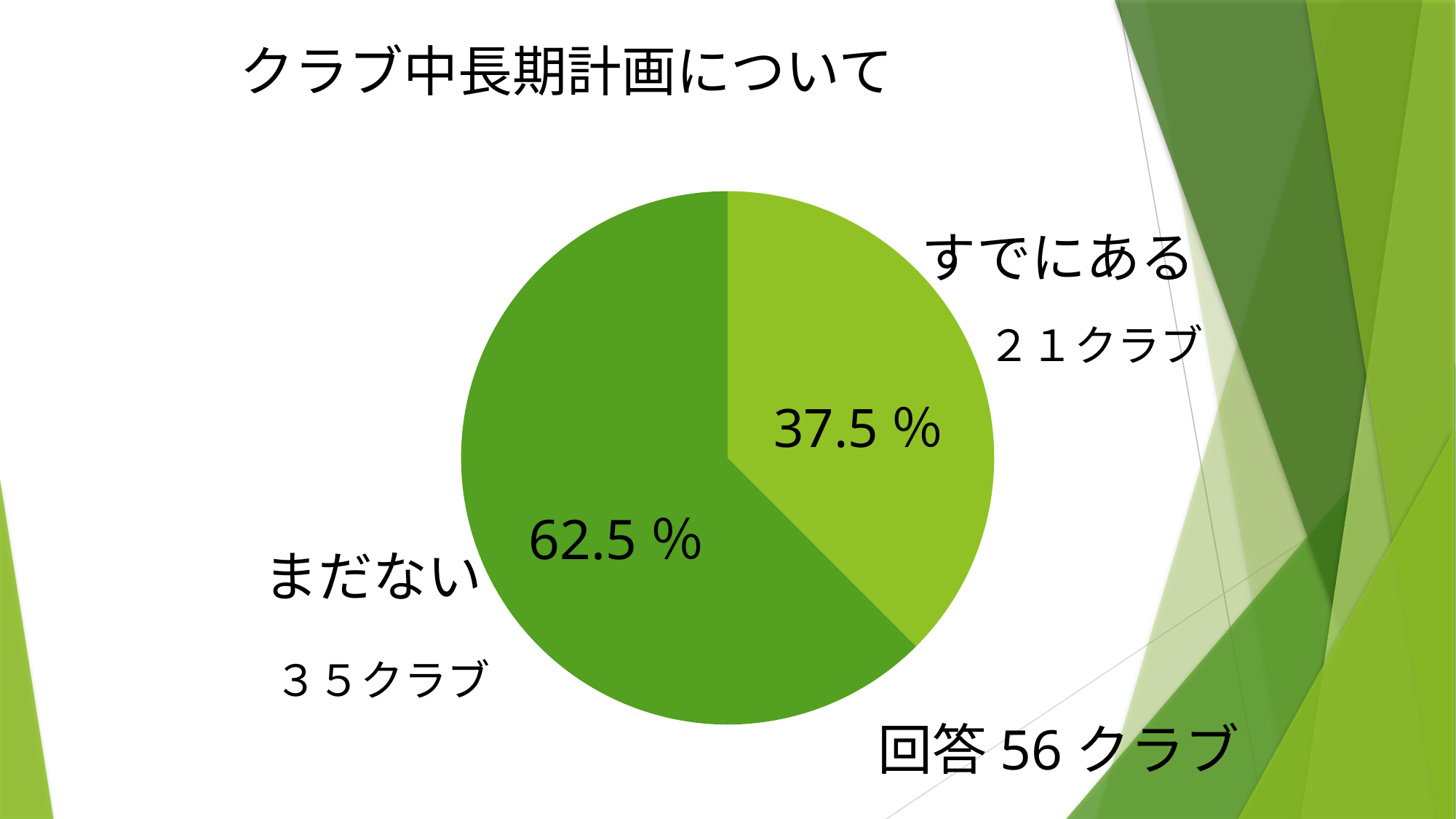
What is the title of the chart on the slide? クラブ中長期計画について What is the difference in percentage points between まだない and すでにある? 25 % How many clubs are labelled for まだない? ３５クラブ How many slices does the pie chart have? 2 What percentage is shown for まだない? 62.5 % What type of chart is shown on the slide? pie chart How many clubs are labelled for すでにある? ２１クラブ Which is larger, the share for すでにある or the share for まだない? まだない Which slice of the pie chart is the smallest? すでにある How many clubs responded in total, according to the slide? 56 クラブ What percentage is shown for すでにある? 37.5 % Which slice of the pie chart is the largest? まだない